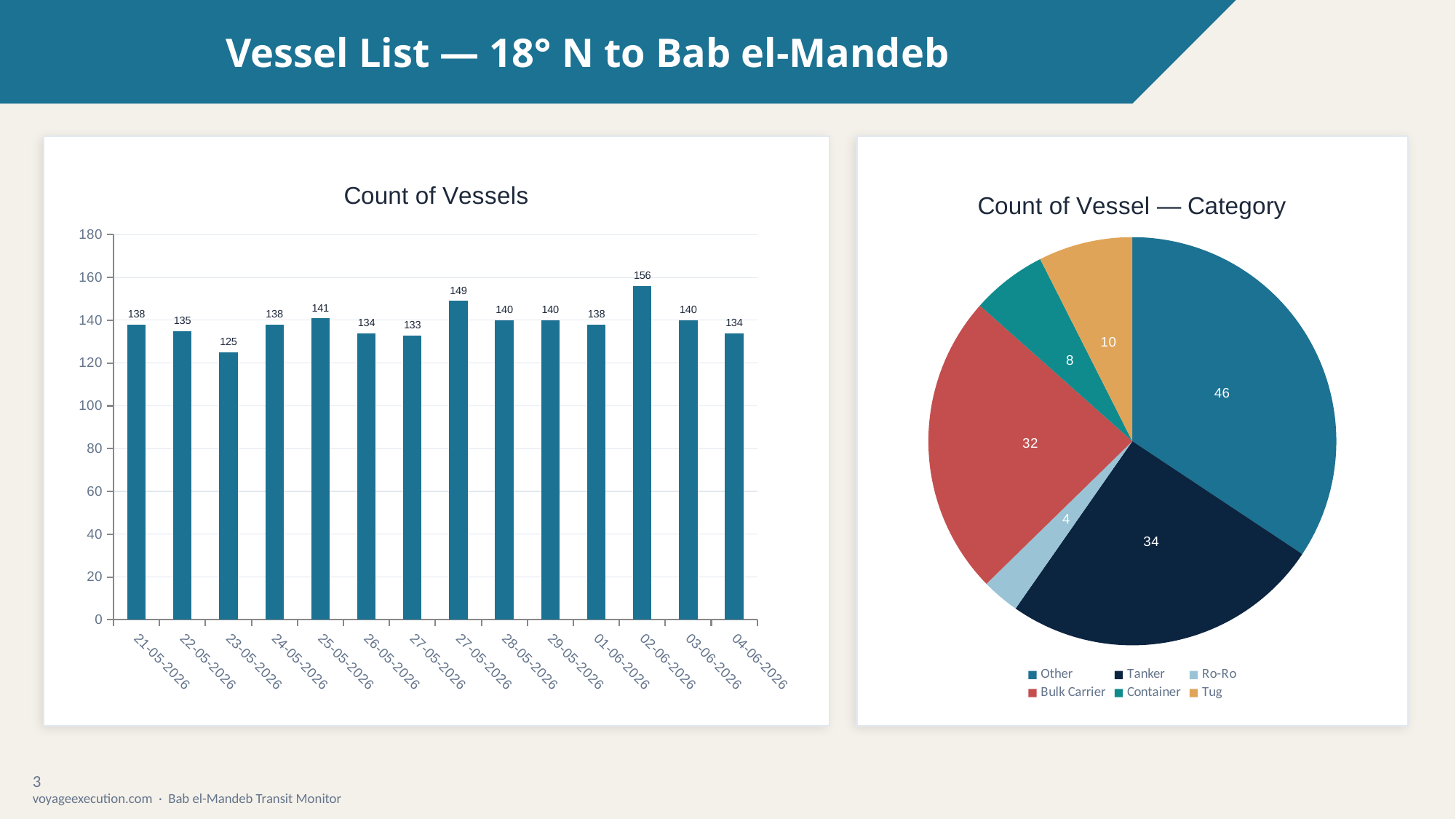
In the Count of Vessels bar chart, which is larger, the value for 25-05-2026 or the value for 26-05-2026? 25-05-2026 In the Count of Vessels bar chart, which date has the lowest count? 23-05-2026 In the Count of Vessel — Category pie chart, what is the difference between the Tanker and Container values? 26 In the Count of Vessel — Category pie chart, which category has the smallest slice? Ro-Ro In the Count of Vessels bar chart, what is the value for 02-06-2026? 156 In the Count of Vessel — Category pie chart, what is the value for Bulk Carrier? 32 In the Count of Vessels bar chart, what is the difference between the values for 02-06-2026 and 23-05-2026? 31 In the Count of Vessels bar chart, which date has the highest count? 02-06-2026 How many bars are in the Count of Vessels bar chart? 14 In the Count of Vessels bar chart, what is the value for 23-05-2026? 125 What kind of chart is the Count of Vessels chart on the left? Bar chart How many categories does the legend of the Count of Vessel — Category pie chart list? 6